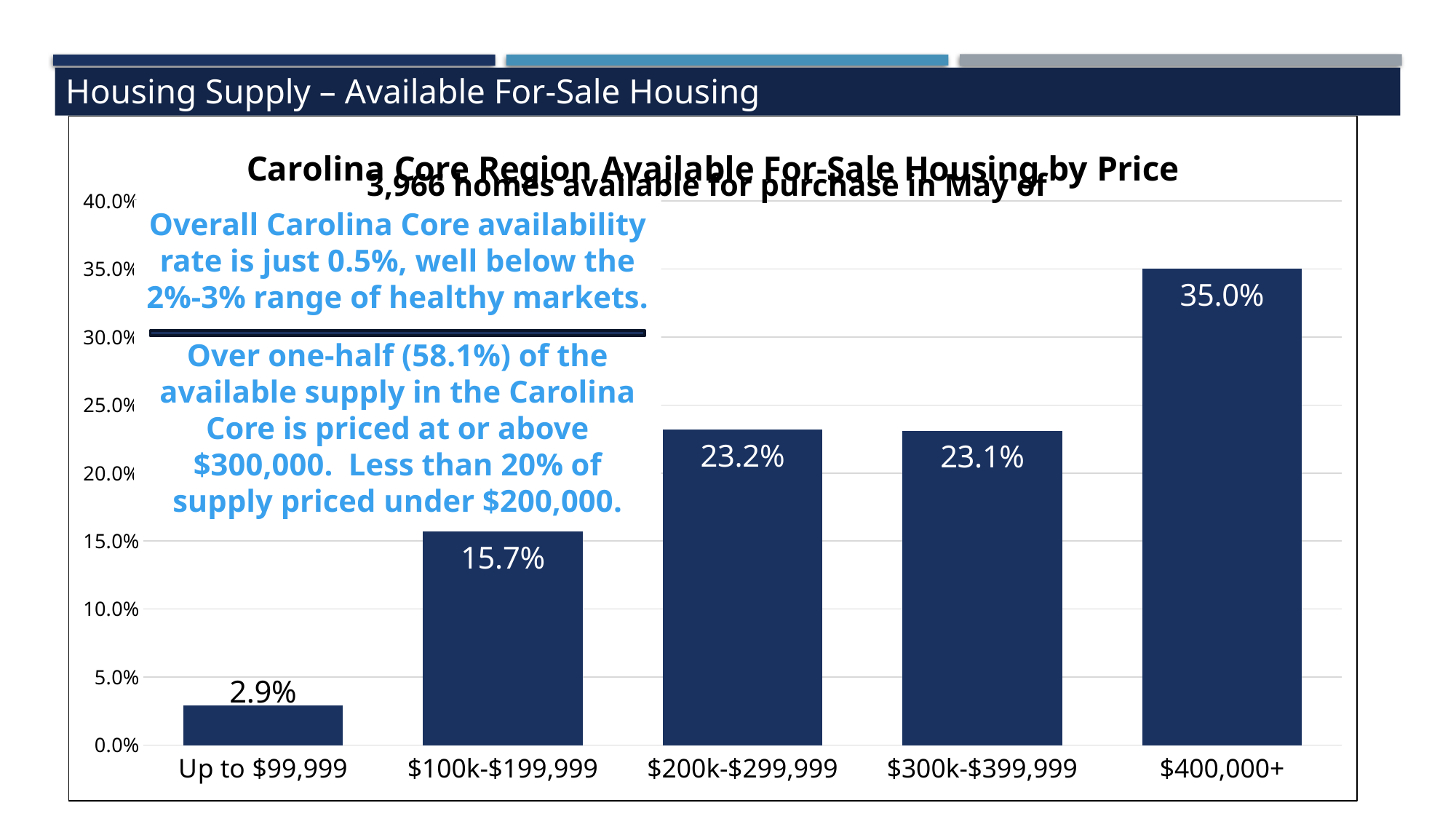
Which price range has the highest share of available for-sale housing? $400,000+ Which price range has the lowest share of available for-sale housing? Up to $99,999 What is the value for the $100k-$199,999 price range? 15.7% What is the value for the $200k-$299,999 price range? 23.2% What is the title of the chart? Carolina Core Region Available For-Sale Housing by Price How many price ranges are shown on the chart? 5 What is the value for the $400,000+ price range? 35.0% Do the values generally rise or fall from the lowest price range to the highest? Rise Which is larger, the value for $100k-$199,999 or the value for $300k-$399,999? $300k-$399,999 What is the value for the Up to $99,999 price range? 2.9% What kind of chart is shown on the slide? Bar chart What is the difference between the values for $400,000+ and $100k-$199,999? 19.3%